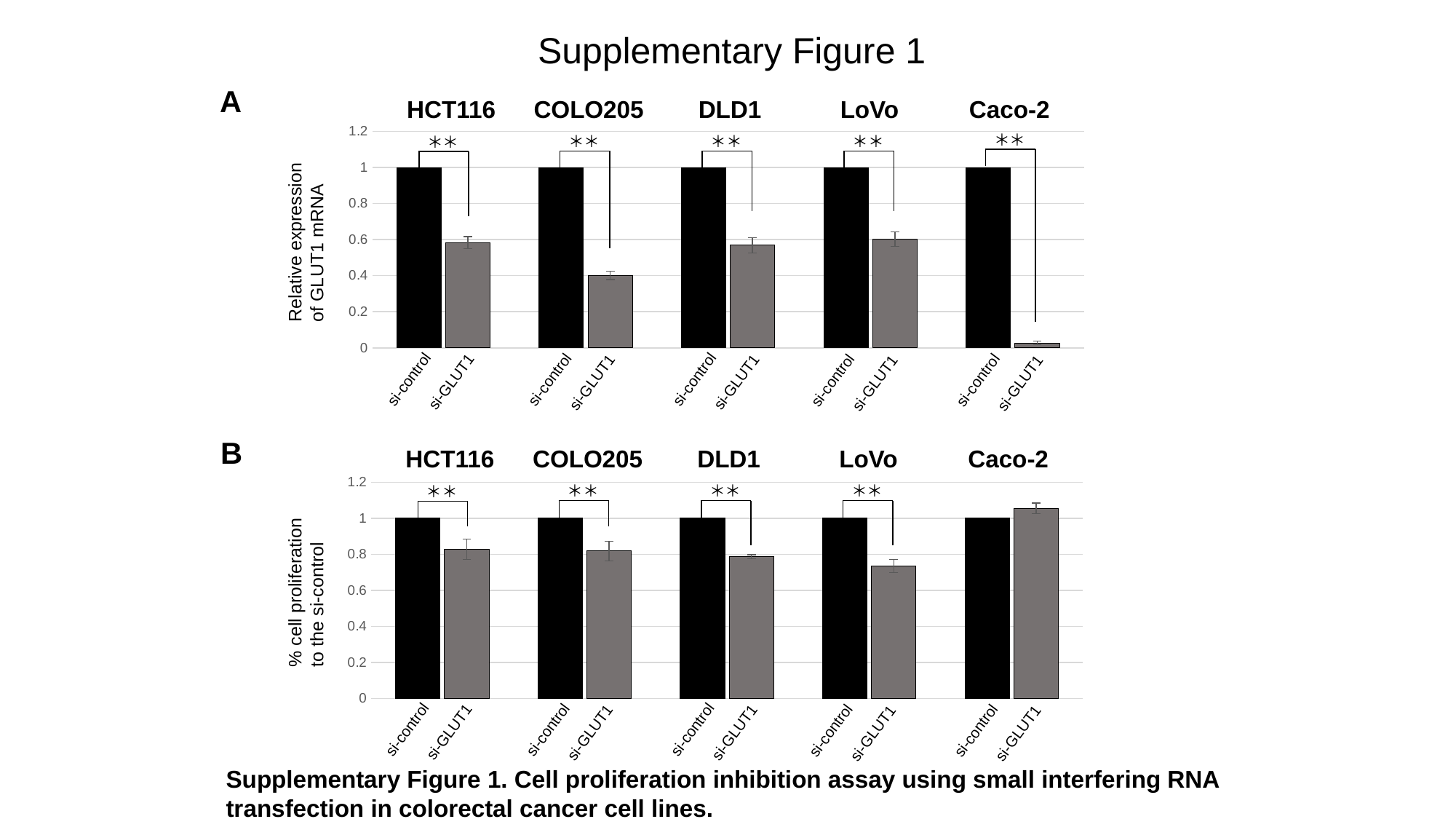
What is the y-axis label of chart A? Relative expression of GLUT1 mRNA In chart B, is the si-GLUT1 value for Caco-2 greater or less than 0.8? greater How many cell lines are shown in chart B? 5 In chart A, which cell line has the lowest si-GLUT1 bar? Caco-2 In chart A, is the si-GLUT1 value for Caco-2 greater or less than 0.2? less In chart A, is the si-GLUT1 value for COLO205 greater or less than 0.6? less In chart A, what is the value of the si-control bar for HCT116? 1 What kind of chart is chart A? bar chart In chart A, which is larger for COLO205: the si-control bar or the si-GLUT1 bar? si-control In chart B, what is the value of the si-control bar for Caco-2? 1 In chart B, which cell line has the highest si-GLUT1 bar? Caco-2